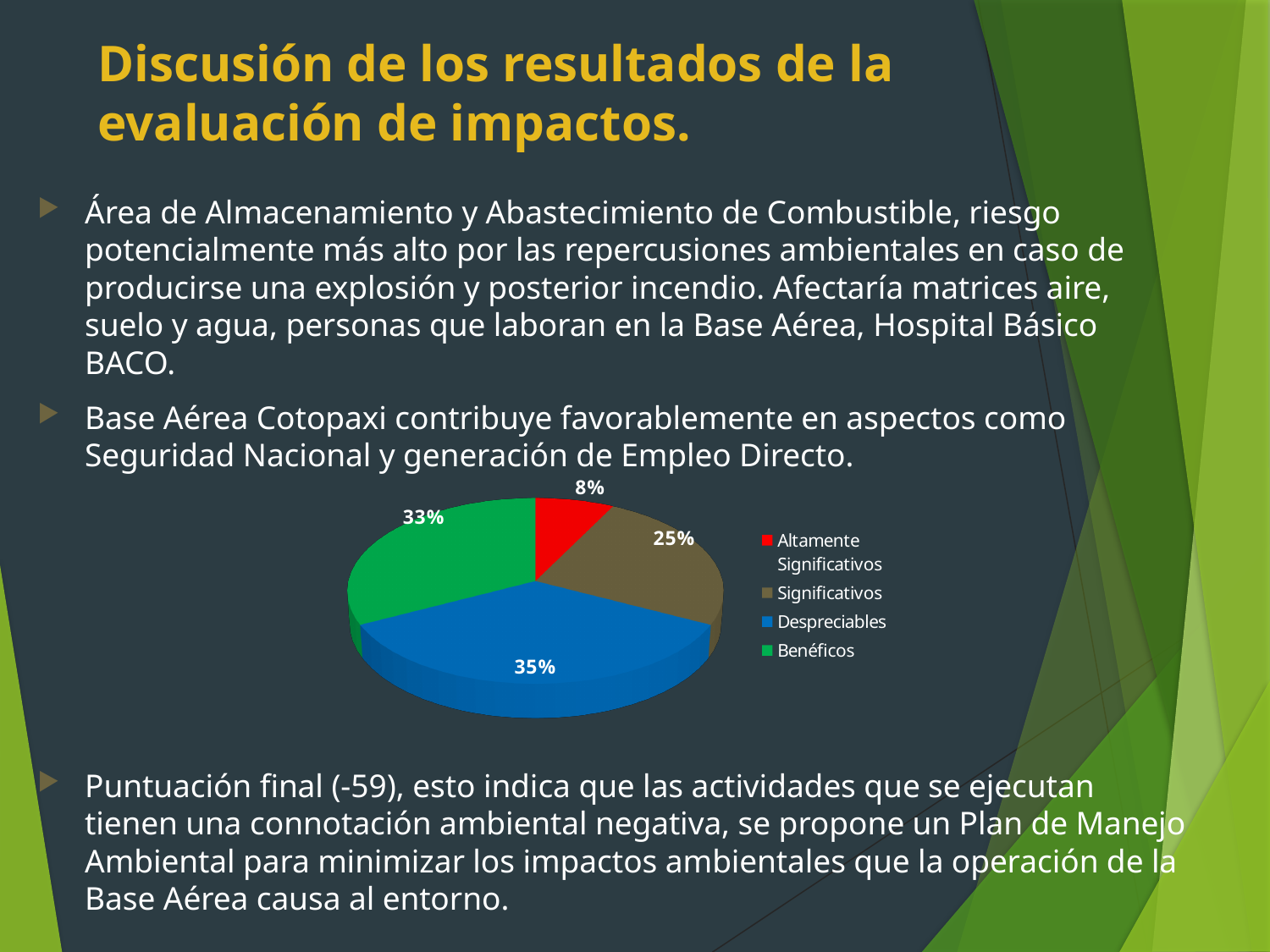
Which category has the largest share of the pie? Despreciables What percentage of the pie corresponds to Significativos? 25% How many categories does the legend of the pie chart list? 4 Which is larger, the share for Benéficos or the share for Significativos? Benéficos What percentage of the pie corresponds to Benéficos? 33% How many slices does the pie chart have? 4 What kind of chart is shown on the slide? pie chart What percentage of the pie corresponds to Altamente Significativos? 8% Which category has the smallest share of the pie? Altamente Significativos What percentage of the pie corresponds to Despreciables? 35% What colour is the slice for Benéficos? green What is the difference in percentage points between Despreciables and Significativos? 10